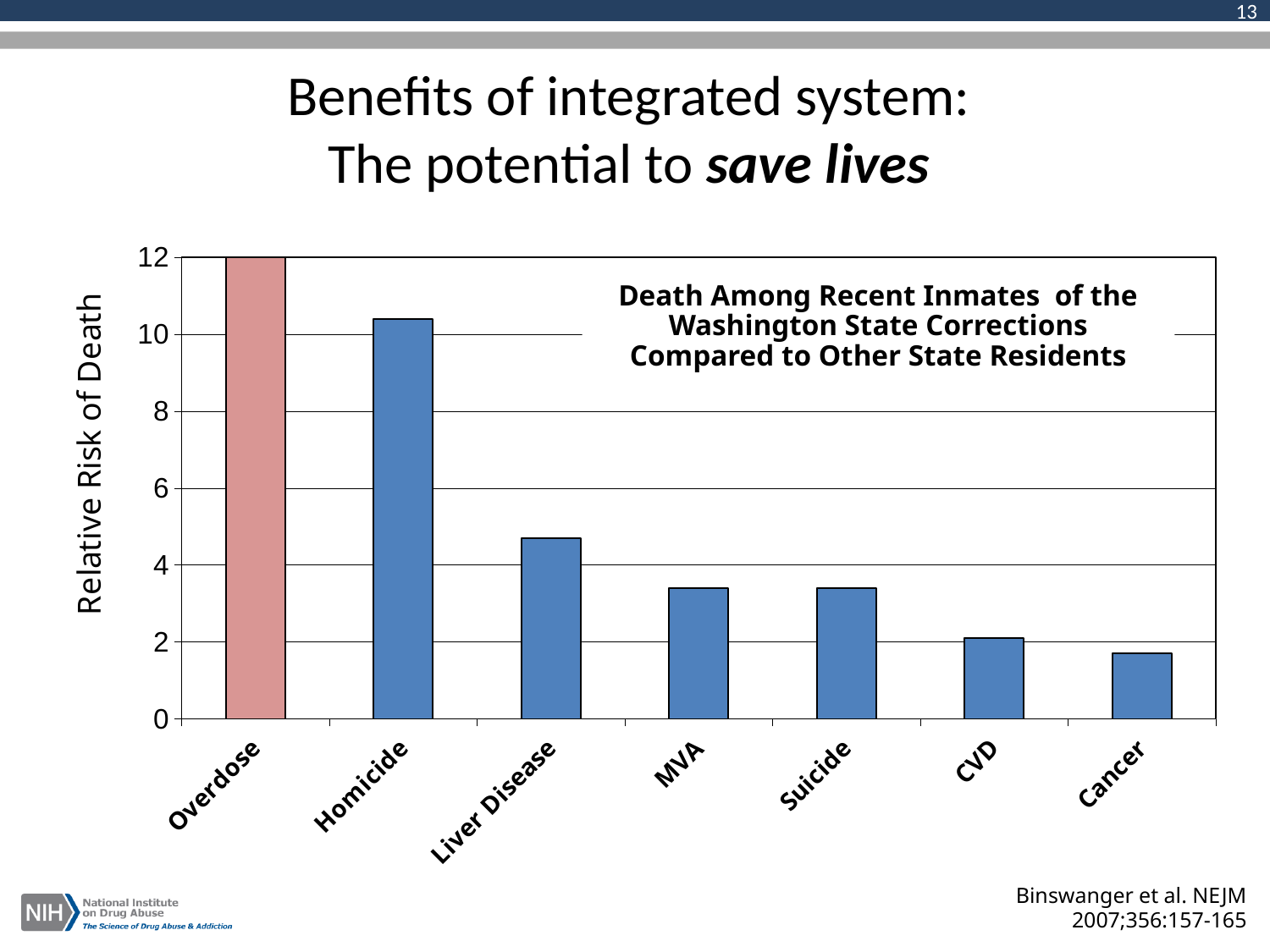
What is the relative risk of death for Overdose in the chart? 12 Which has a higher relative risk of death, Homicide or Liver Disease? Homicide Is the relative risk of death for CVD greater or less than 4? less Do the bar values generally rise or fall from left to right along the x axis? fall Is the relative risk of death for Liver Disease greater or less than 4? greater Is the relative risk of death for Homicide greater or less than 10? greater What type of chart is shown on the slide? bar chart Which cause of death has the lowest relative risk in the chart? Cancer How many causes of death are shown on the x axis of the chart? 7 What is the label on the y axis of the chart? Relative Risk of Death Which cause of death has the highest relative risk in the chart? Overdose